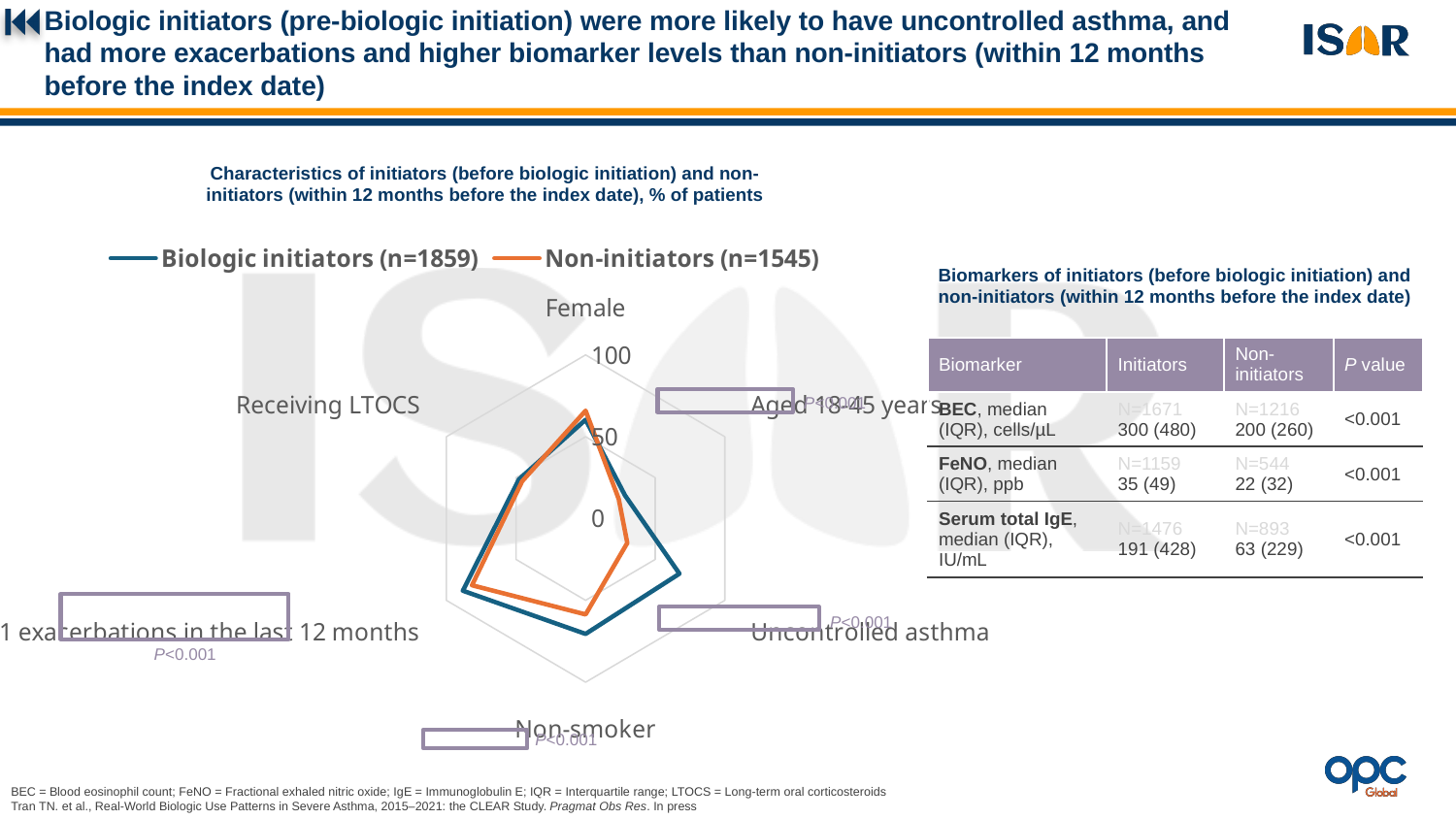
Is the value for Aged 18-45 years for Biologic initiators greater or less than 50? less What are the two series named in the chart legend? Biologic initiators (n=1859) and Non-initiators (n=1545) For Biologic initiators, which category has the highest value? ≥1 exacerbations in the last 12 months For Biologic initiators, which category has the lowest value? Aged 18-45 years Is the value for Female for Non-initiators greater or less than 50? greater Which series has the larger value for Receiving LTOCS, Biologic initiators or Non-initiators? Biologic initiators (n=1859) What kind of chart is shown on the slide? Radar chart How many series does the chart legend list? 2 Is the value for Uncontrolled asthma for Non-initiators greater or less than 50? less How many categories (axes) does the radar chart have? 6 Which series has the larger value for Uncontrolled asthma, Biologic initiators or Non-initiators? Biologic initiators (n=1859)